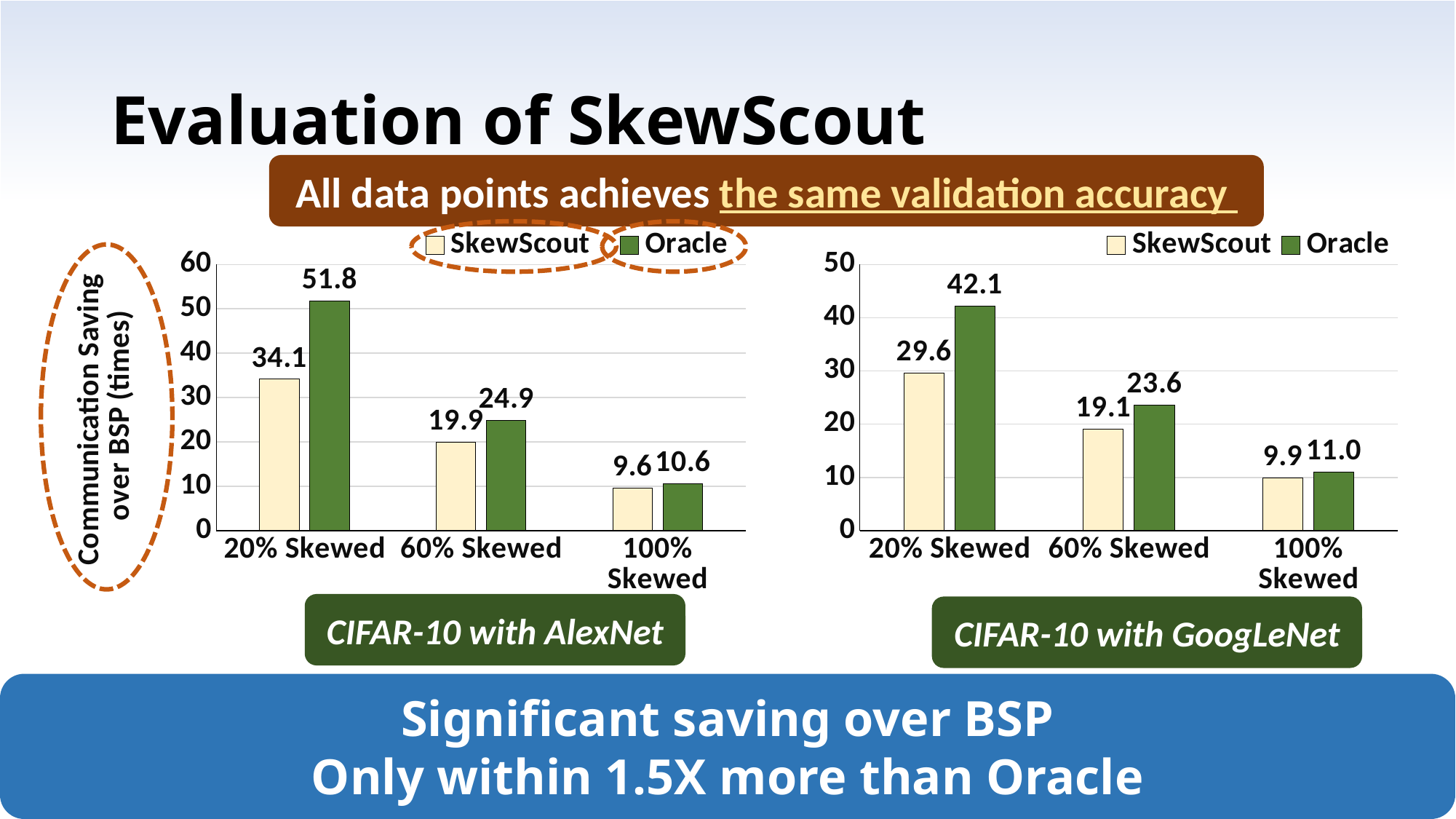
In the CIFAR-10 with AlexNet chart, what is the communication saving for SkewScout at 20% Skewed? 34.1 In the CIFAR-10 with GoogLeNet chart, what is the difference between the Oracle and SkewScout values at 60% Skewed? 4.5 In the CIFAR-10 with GoogLeNet chart, what is the value for SkewScout at 100% Skewed? 9.9 What kind of chart is the CIFAR-10 with GoogLeNet chart? Bar chart In the CIFAR-10 with AlexNet chart, what is the difference between the Oracle and SkewScout values at 20% Skewed? 17.7 In the CIFAR-10 with GoogLeNet chart, which category has the lowest SkewScout value? 100% Skewed In the CIFAR-10 with GoogLeNet chart, what is the value for Oracle at 20% Skewed? 42.1 In the CIFAR-10 with AlexNet chart, what is the value for Oracle at 60% Skewed? 24.9 How many series does the legend of the CIFAR-10 with AlexNet chart list? 2 In the CIFAR-10 with AlexNet chart, do the SkewScout values rise or fall as the skew increases from 20% to 100%? Fall In the CIFAR-10 with AlexNet chart, which category has the highest Oracle value? 20% Skewed In the CIFAR-10 with GoogLeNet chart, which is larger at 20% Skewed: SkewScout or Oracle? Oracle